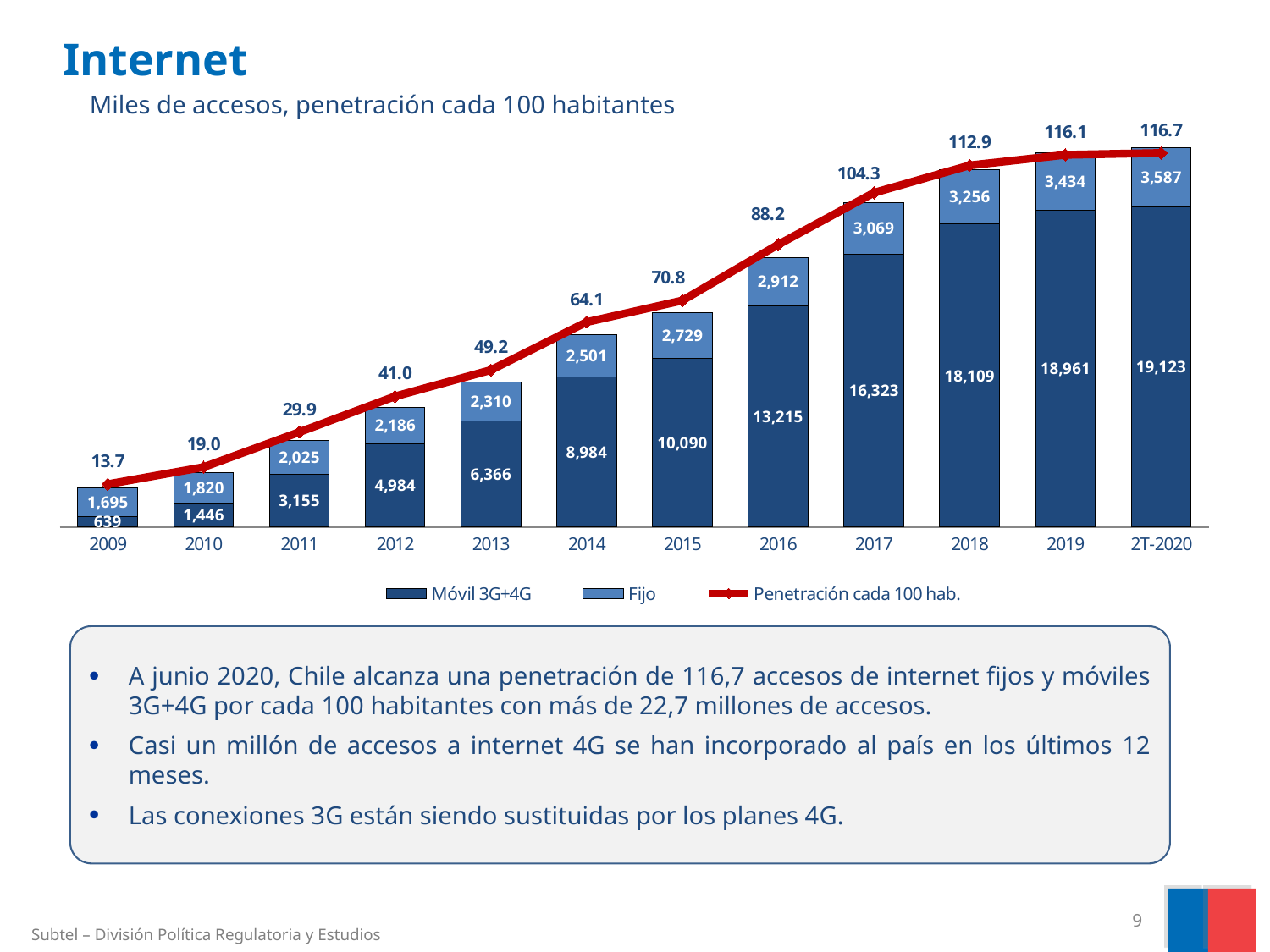
Which category has the highest Fijo value? 2T-2020 Does the Penetración cada 100 hab. line rise or fall from 2009 to 2T-2020? Rises How many series does the legend list? 3 Which year has the lowest Móvil 3G+4G value? 2009 What is the Fijo value for 2013? 2,310 What is the Penetración cada 100 hab. value for 2017? 104.3 Which is larger, the Fijo value for 2009 or the Móvil 3G+4G value for 2009? Fijo (1,695) What is the Móvil 3G+4G value for 2016? 13,215 How many categories are shown on the x axis? 12 What is the difference between the Móvil 3G+4G values for 2T-2020 and 2019? 162 What kind of chart is shown on the slide? Stacked bar chart with a line What is the total of the stacked bar for 2T-2020 (Móvil 3G+4G plus Fijo)? 22,710